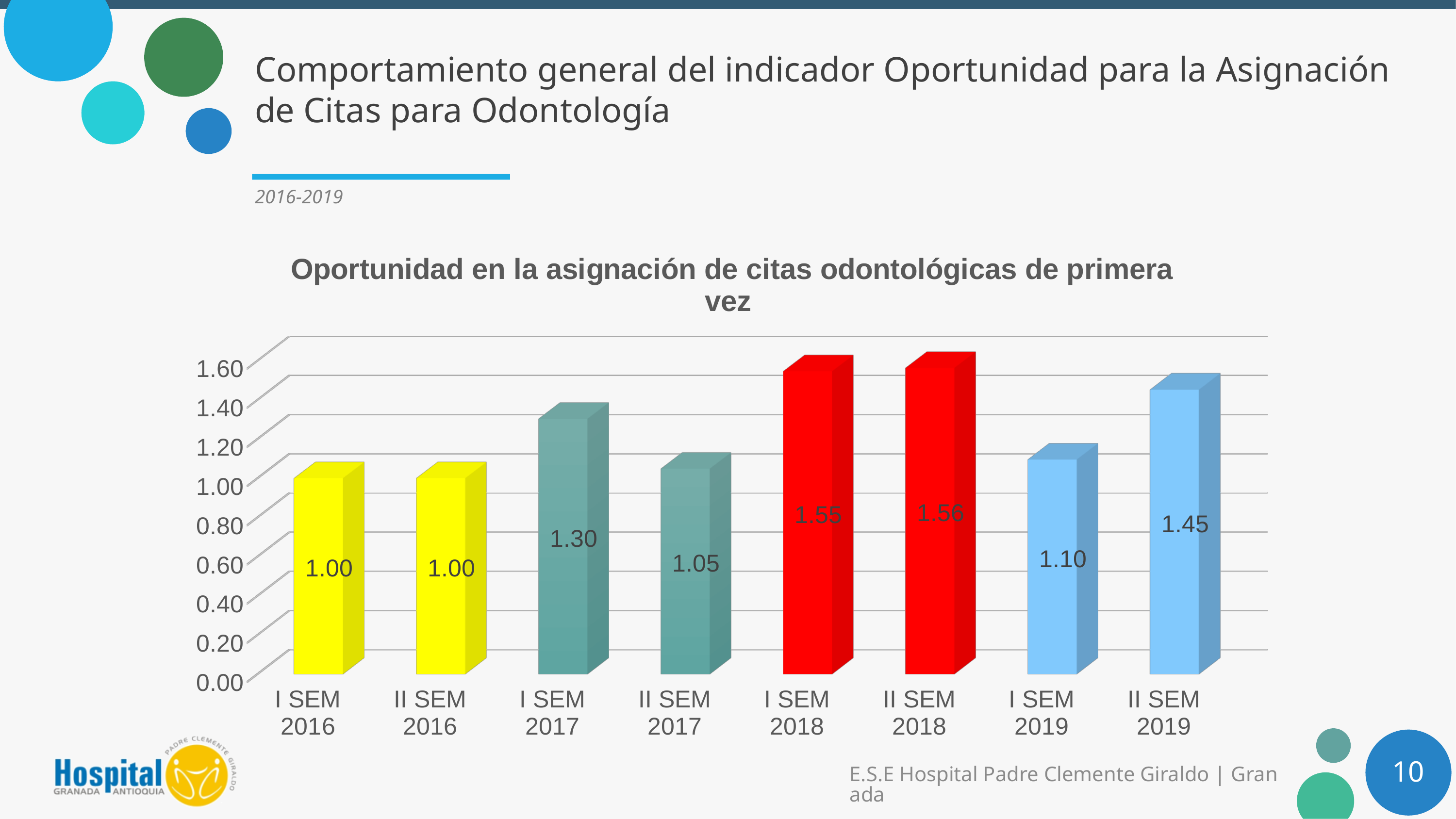
What is the difference between the values for II SEM 2019 and I SEM 2019? 0.35 Which period has the highest value? II SEM 2018 Do the values rise or fall from I SEM 2019 to II SEM 2019? Rise How many periods are shown on the x axis? 8 What is the difference between the values for I SEM 2017 and II SEM 2017? 0.25 What kind of chart is this? Bar chart What is the value for I SEM 2019? 1.10 What is the value for II SEM 2017? 1.05 Which is larger, the value for I SEM 2017 or the value for II SEM 2019? II SEM 2019 What is the value for II SEM 2018? 1.56 What is the title of the chart? Oportunidad en la asignación de citas odontológicas de primera vez What is the value for I SEM 2017? 1.30